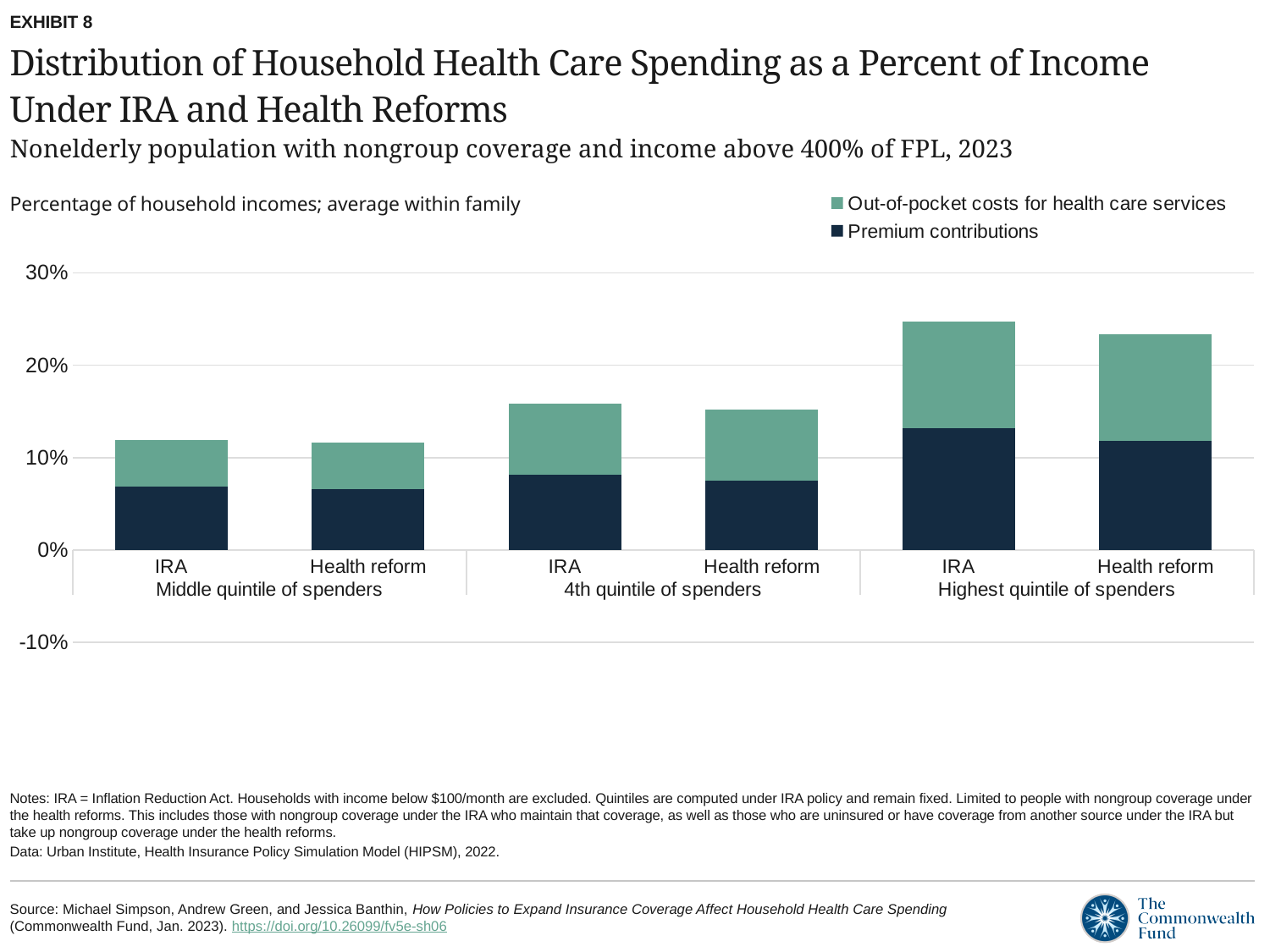
Is the Premium contributions value for IRA in the Highest quintile of spenders greater or less than 10%? greater Is the total for IRA in the Highest quintile of spenders greater or less than 20%? greater Do the total bar heights rise or fall moving from the Middle quintile to the Highest quintile of spenders? Rise Which legend entry is shown in the dark navy colour? Premium contributions How many series does the legend list? 2 How many bars are plotted in the chart? 6 Is the total for IRA in the 4th quintile of spenders greater or less than 10%? greater In the Highest quintile of spenders, which has the larger total: IRA or Health reform? IRA Which bar has the lowest total household health care spending as a percent of income? Health reform, Middle quintile of spenders What kind of chart is shown on the slide? Stacked bar chart Which bar has the highest total household health care spending as a percent of income? IRA, Highest quintile of spenders